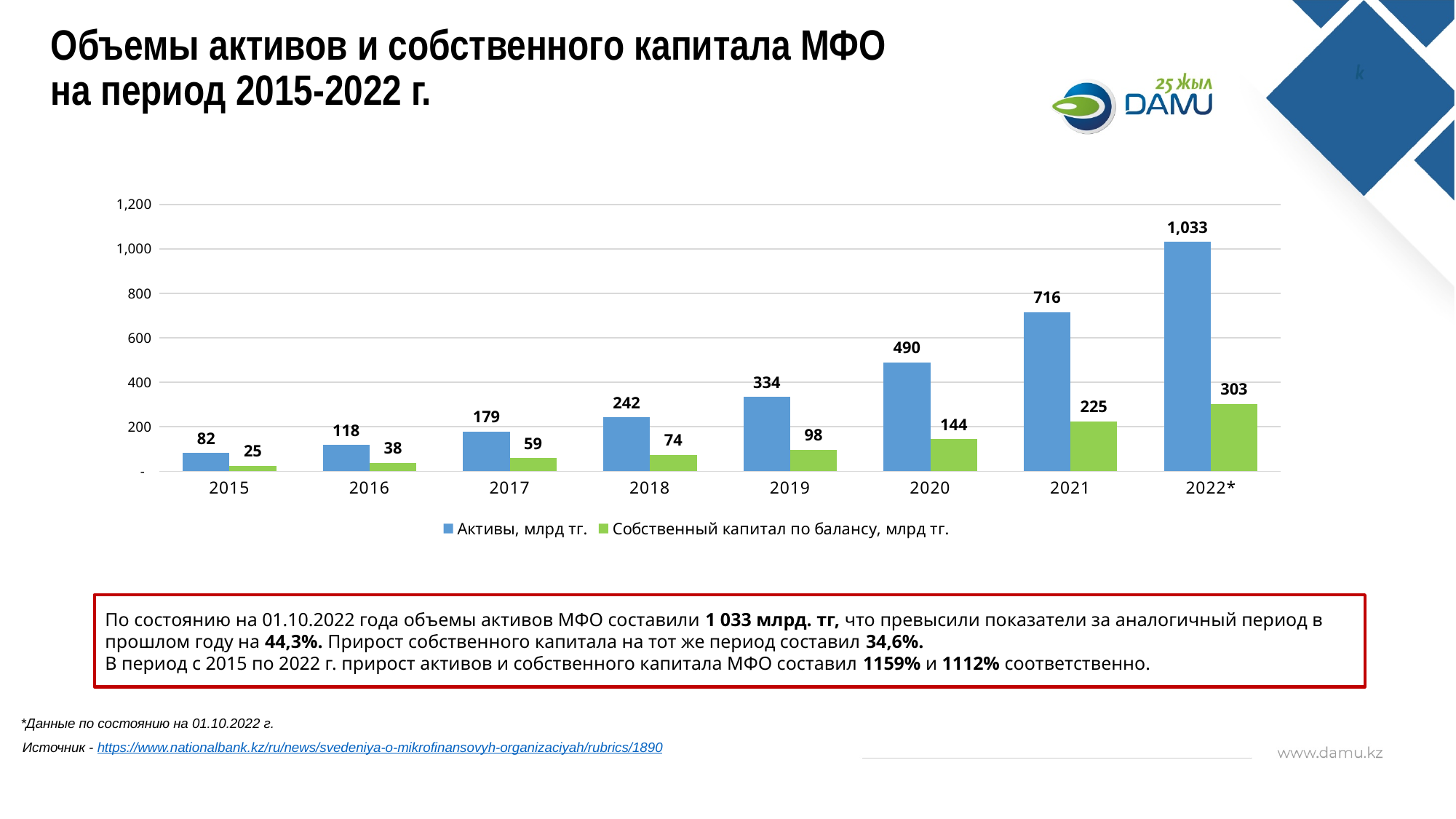
Is the value of Активы, млрд тг. for 2019 greater or less than 400? less Which year has the highest value for Собственный капитал по балансу, млрд тг.? 2022* What is the value of Собственный капитал по балансу, млрд тг. for 2018? 74 How many years are shown on the x axis? 8 How many series does the legend list? 2 Do the values of Активы, млрд тг. rise or fall from 2015 to 2022*? rise Which is larger: Собственный капитал по балансу, млрд тг. in 2019 or Активы, млрд тг. in 2015? Собственный капитал по балансу, млрд тг. in 2019 What is the difference between Активы, млрд тг. in 2021 and in 2020? 226 Which year has the lowest value for Активы, млрд тг.? 2015 What is the value of Активы, млрд тг. for 2020? 490 What kind of chart is shown on the slide? bar chart What is the value of Активы, млрд тг. for 2022*? 1,033